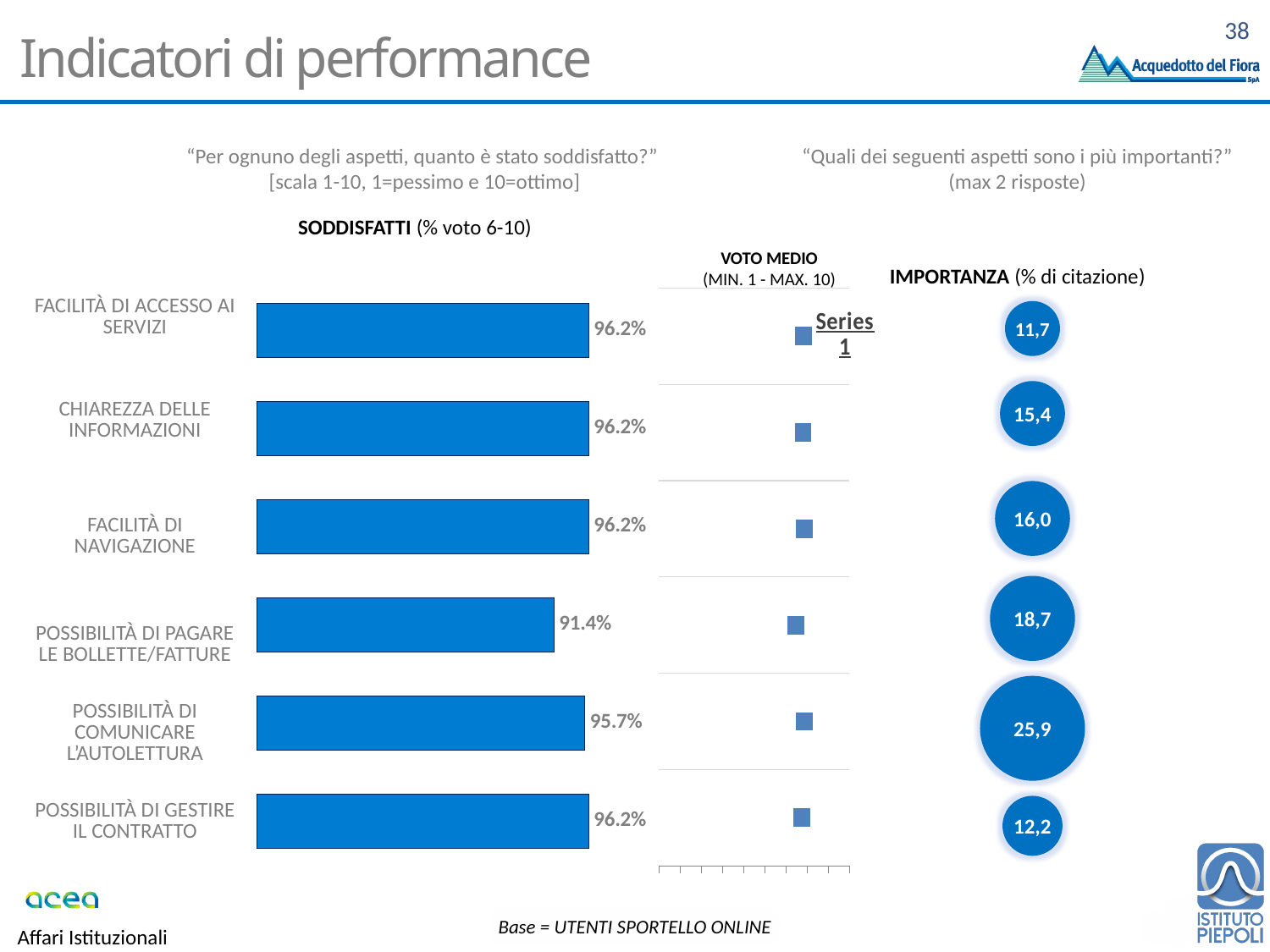
In the IMPORTANZA (% di citazione) chart, what is the value for POSSIBILITÀ DI COMUNICARE L'AUTOLETTURA? 25,9 In the IMPORTANZA (% di citazione) chart, which category has the lowest value? FACILITÀ DI ACCESSO AI SERVIZI In the SODDISFATTI (% voto 6-10) chart, what is the value for POSSIBILITÀ DI COMUNICARE L'AUTOLETTURA? 95.7% In the SODDISFATTI (% voto 6-10) chart, what is the difference between the value for FACILITÀ DI ACCESSO AI SERVIZI and the value for POSSIBILITÀ DI PAGARE LE BOLLETTE/FATTURE? 4.8% In the SODDISFATTI (% voto 6-10) chart, which is larger: the value for POSSIBILITÀ DI COMUNICARE L'AUTOLETTURA or the value for POSSIBILITÀ DI PAGARE LE BOLLETTE/FATTURE? POSSIBILITÀ DI COMUNICARE L'AUTOLETTURA In the IMPORTANZA (% di citazione) chart, what is the difference between the value for POSSIBILITÀ DI COMUNICARE L'AUTOLETTURA and the value for FACILITÀ DI ACCESSO AI SERVIZI? 14,2 How many categories are shown in the SODDISFATTI (% voto 6-10) chart? 6 In the SODDISFATTI (% voto 6-10) chart, which category has the lowest value? POSSIBILITÀ DI PAGARE LE BOLLETTE/FATTURE In the SODDISFATTI (% voto 6-10) chart, what is the value for FACILITÀ DI NAVIGAZIONE? 96.2% In the SODDISFATTI (% voto 6-10) chart, what is the value for POSSIBILITÀ DI PAGARE LE BOLLETTE/FATTURE? 91.4% What kind of chart is the SODDISFATTI (% voto 6-10) chart? Bar chart